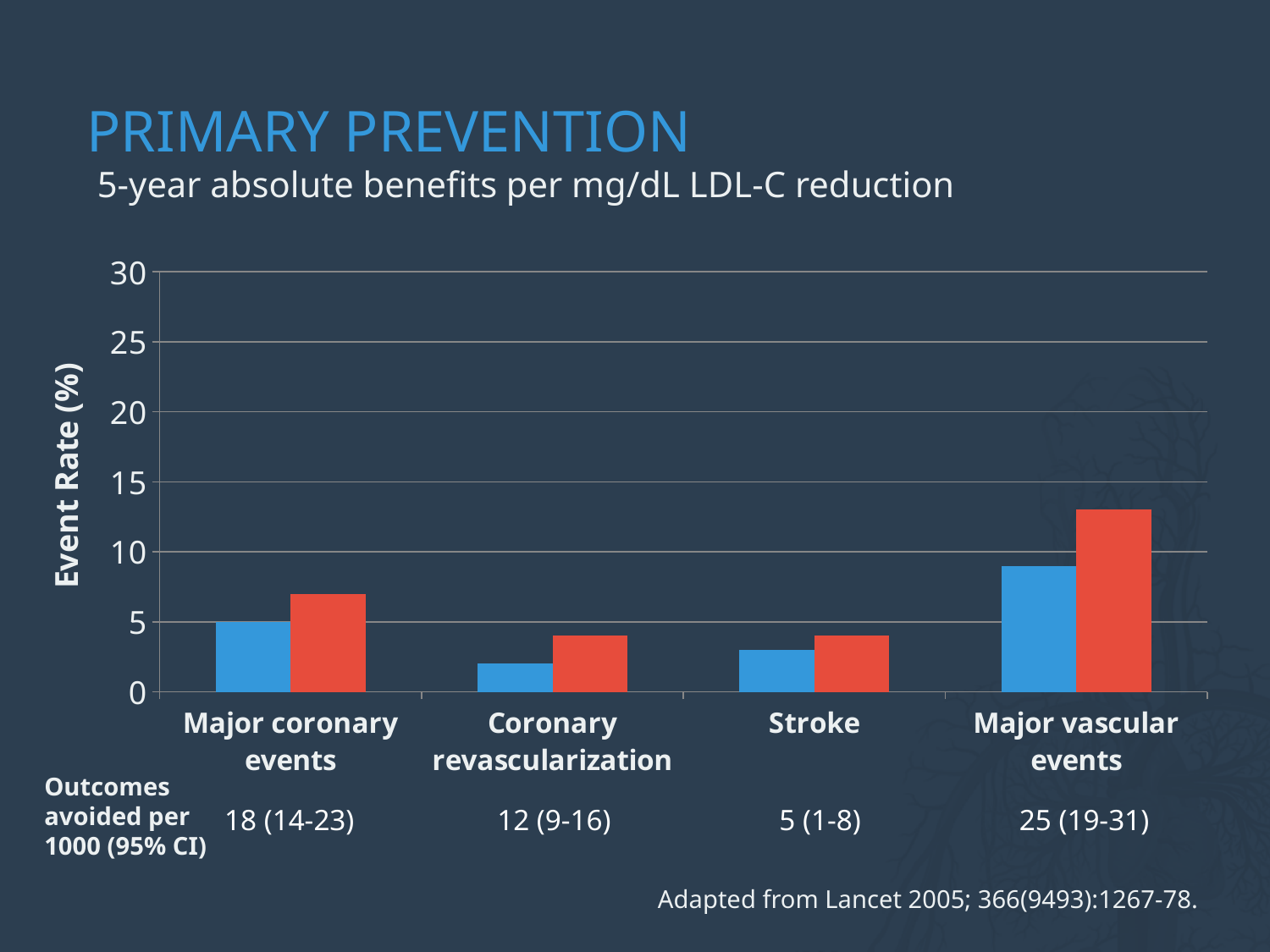
Which is larger: the blue bar for Major coronary events or the blue bar for Stroke? Major coronary events Is the red bar for Major coronary events greater or less than 5? greater How many outcome categories are shown on the x axis of the chart? 4 Is the blue bar for Coronary revascularization greater or less than 5? less What is the label on the y axis of the chart? Event Rate (%) Is the red bar for Major vascular events greater or less than 10? greater Which category has the tallest red bar? Major vascular events According to the row below the chart, how many outcomes are avoided per 1000 (95% CI) for Stroke? 5 (1-8) For Stroke, which bar is taller, the blue bar or the red bar? red What kind of chart is shown on the slide? bar chart Which category has the shortest blue bar? Coronary revascularization